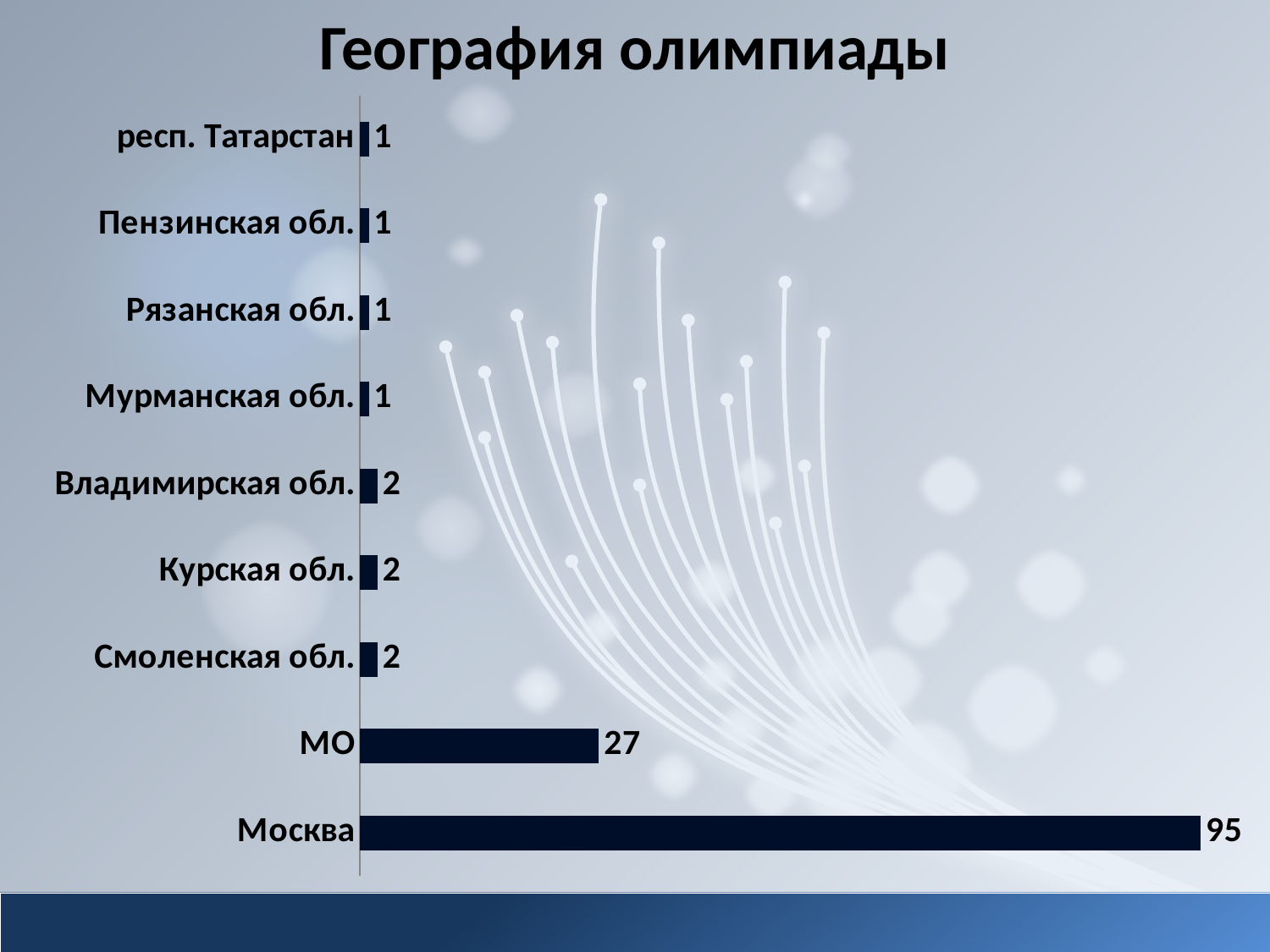
What is the difference between the values for Москва and МО? 68 What is the value for Смоленская обл.? 2 What is the title of the chart? География олимпиады What is the value for Мурманская обл.? 1 What is the value for Москва? 95 Which category has the highest value? Москва Which is larger, the value for МО or the value for Владимирская обл.? МО How many categories are shown in the chart? 9 What is the difference between the values for Курская обл. and Рязанская обл.? 1 What is the value for МО? 27 What kind of chart is shown on the slide? bar chart How many categories have a value of 1? 4